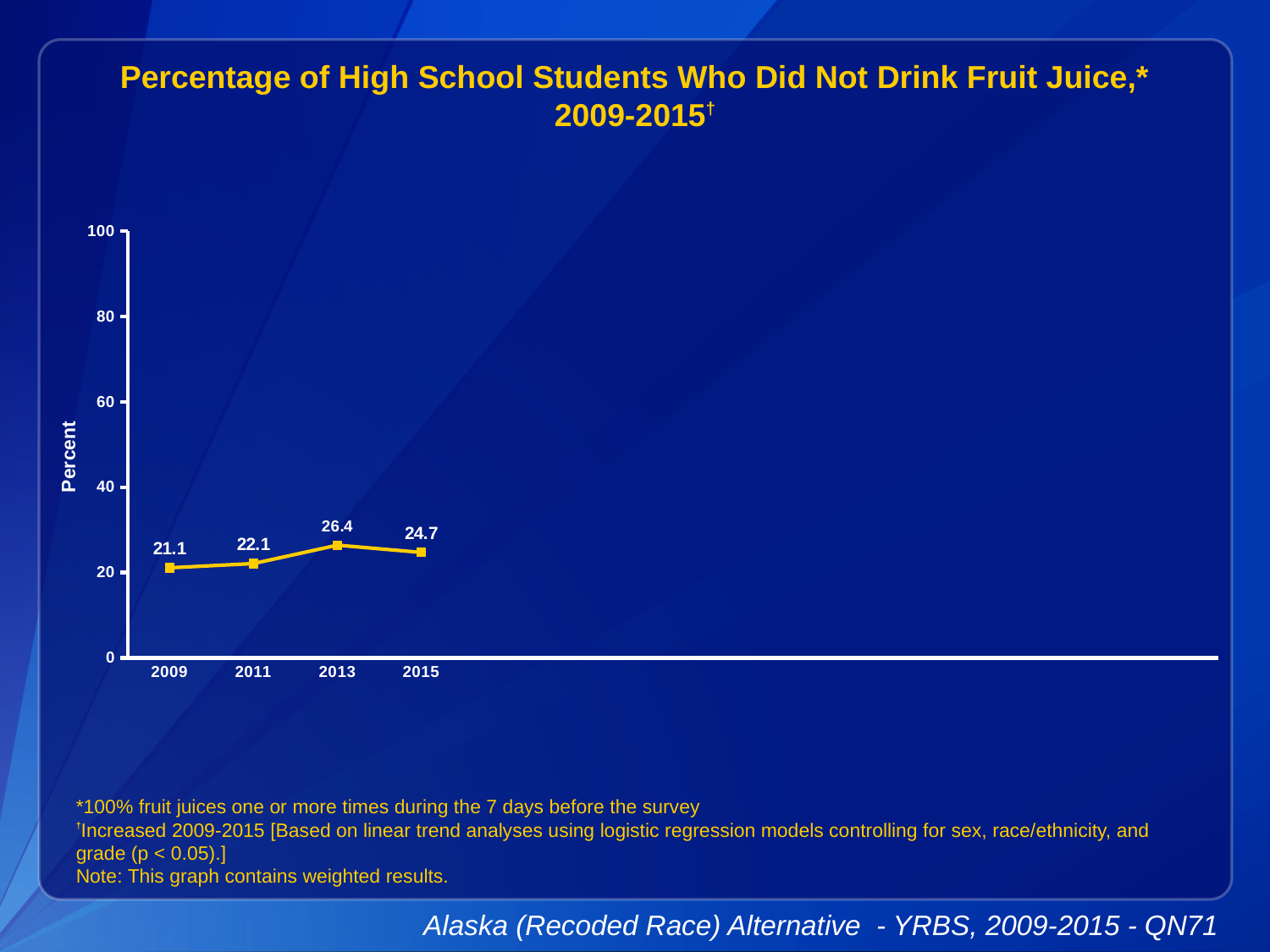
Which year has the lowest value? 2009 What is the label on the y axis? Percent What kind of chart is shown? line chart What is the value for 2009? 21.1 Which is larger, the value for 2011 or the value for 2015? 2015 Is the value for 2013 greater or less than 40? less What is the difference between the values for 2013 and 2009? 5.3 What is the value for 2015? 24.7 Which year has the highest value? 2013 How many years are plotted on the chart? 4 Does the value rise or fall from 2009 to 2013? rise What is the value for 2013? 26.4